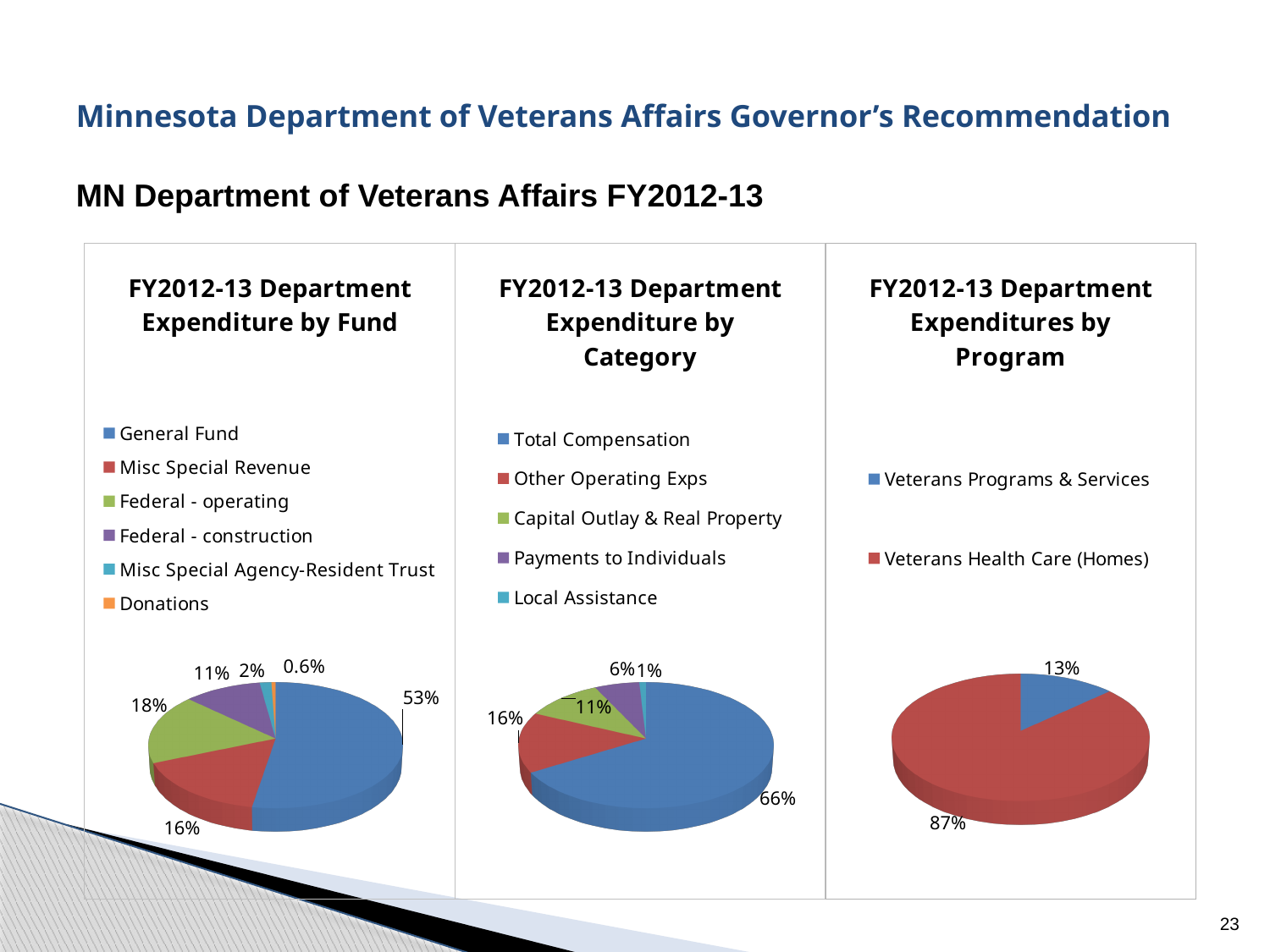
In the 'FY2012-13 Department Expenditure by Category' chart, which category has the largest share? Total Compensation In the 'FY2012-13 Department Expenditure by Category' chart, what share does Local Assistance have? 1% In the 'FY2012-13 Department Expenditure by Category' chart, which is larger: Other Operating Exps or Capital Outlay & Real Property? Other Operating Exps In the 'FY2012-13 Department Expenditure by Fund' chart, what is the difference between the Federal - operating share and the Federal - construction share? 7% In the 'FY2012-13 Department Expenditure by Fund' chart, how many funds does the legend list? 6 In the 'FY2012-13 Department Expenditure by Fund' chart, what share does the General Fund have? 53% In the 'FY2012-13 Department Expenditures by Program' chart, what share does Veterans Health Care (Homes) have? 87% What type of chart is the 'FY2012-13 Department Expenditures by Program' chart? Pie chart In the 'FY2012-13 Department Expenditures by Program' chart, what is the difference between the Veterans Health Care (Homes) share and the Veterans Programs & Services share? 74% In the 'FY2012-13 Department Expenditure by Fund' chart, which fund has the smallest share? Donations